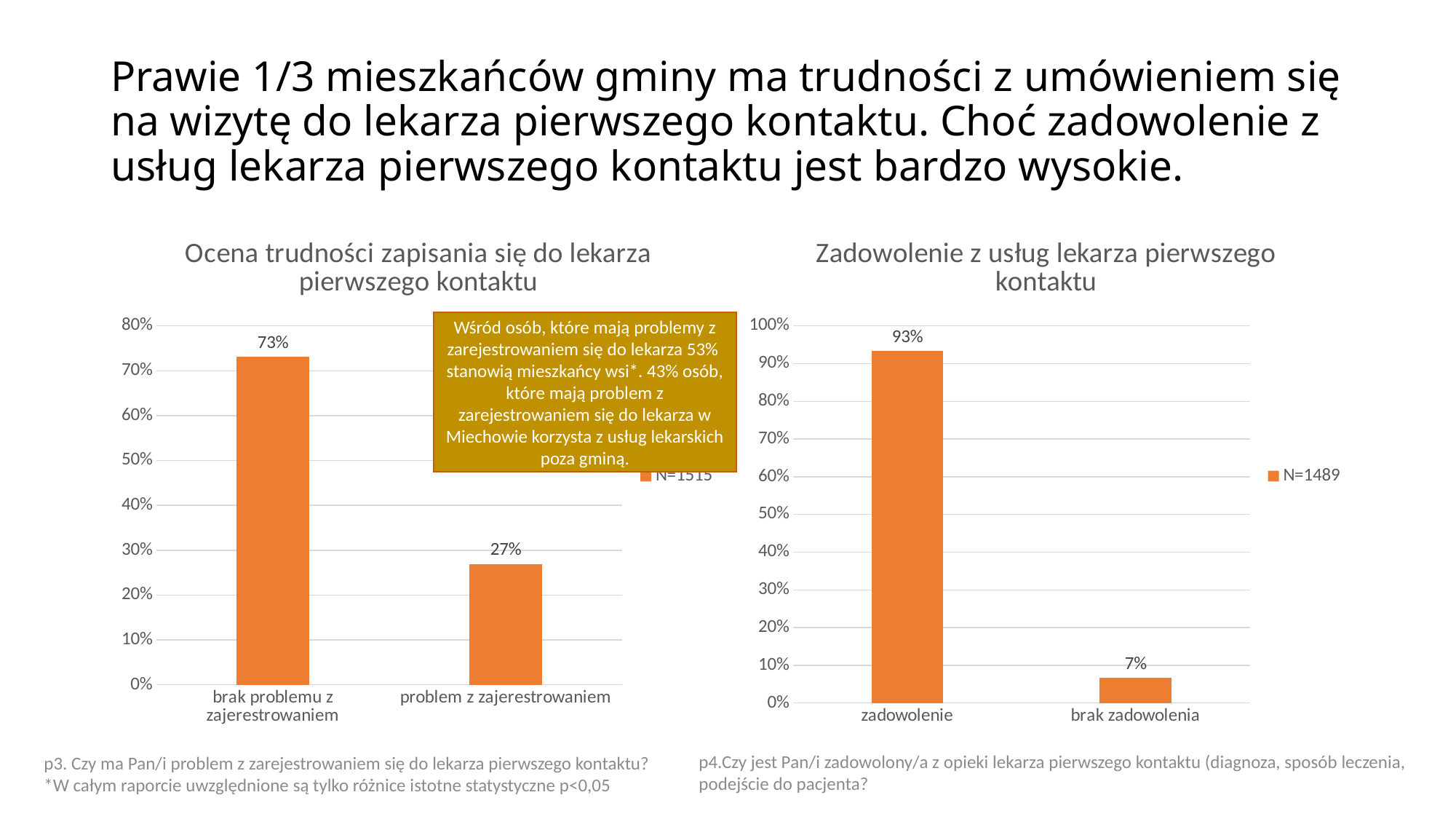
In the left chart, what is the difference between 'brak problemu z zajerestrowaniem' and 'problem z zajerestrowaniem'? 46% In the chart 'Zadowolenie z usług lekarza pierwszego kontaktu', what is the value for 'brak zadowolenia'? 7% What kind of chart is the 'Zadowolenie z usług lekarza pierwszego kontaktu' chart? bar chart In the chart 'Ocena trudności zapisania się do lekarza pierwszego kontaktu', what is the value for 'problem z zajerestrowaniem'? 27% In the right chart, which is larger: 'zadowolenie' or 'brak zadowolenia'? zadowolenie In the right chart, which category has the lowest value? brak zadowolenia How many categories are shown in the left chart? 2 In the chart 'Ocena trudności zapisania się do lekarza pierwszego kontaktu', what is the value for 'brak problemu z zajerestrowaniem'? 73% In the chart 'Zadowolenie z usług lekarza pierwszego kontaktu', what is the value for 'zadowolenie'? 93% In the right chart, what is the difference between 'zadowolenie' and 'brak zadowolenia'? 86% What legend entry is shown for the right chart? N=1489 In the left chart, which category has the highest value? brak problemu z zajerestrowaniem